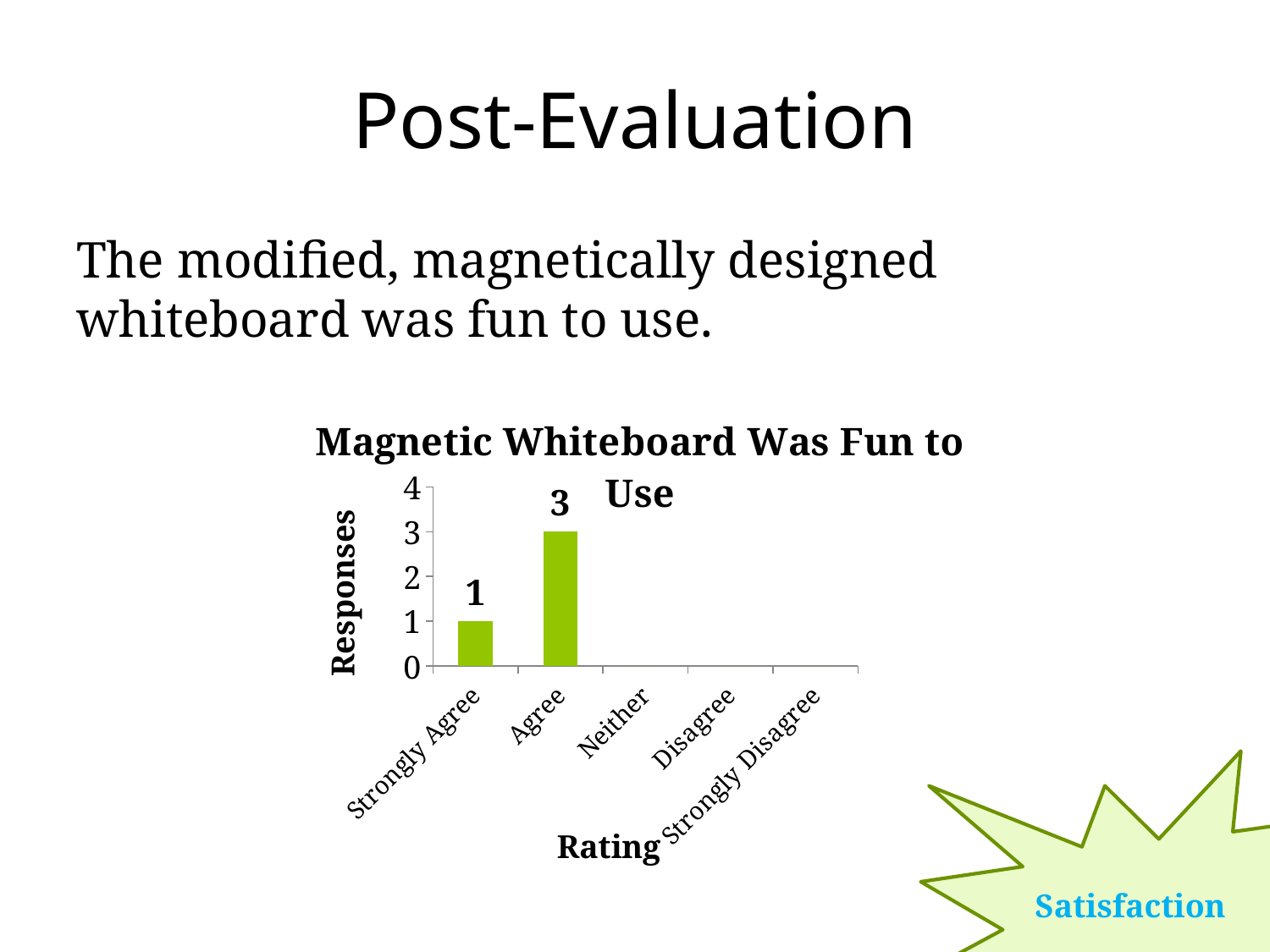
What is the value for Strongly Agree? 1 What is the highest tick value shown on the vertical axis? 4 What is the value for Agree? 3 How many categories are shown on the x axis? 5 What is the title of the chart? Magnetic Whiteboard Was Fun to Use What kind of chart is shown? bar chart What is the total of the values for Strongly Agree and Agree? 4 Which category has the highest value? Agree What is the difference between the values for Agree and Strongly Agree? 2 Which is larger, the value for Agree or the value for Strongly Agree? Agree What is the label of the vertical axis? Responses Is the value for Agree greater or less than 2? greater